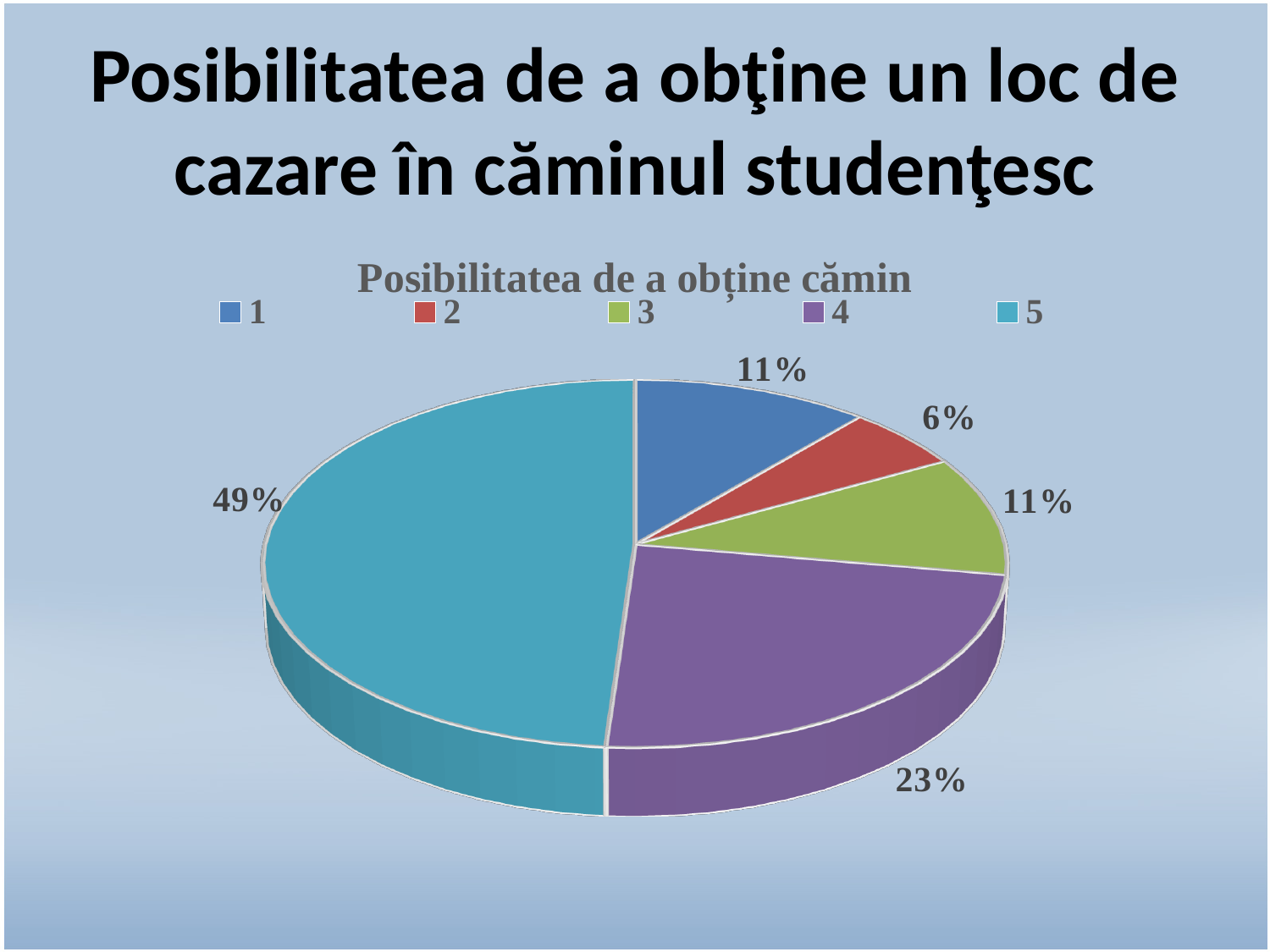
Which category has the largest slice? 5 What is the value for category 1? 11% Which is larger, the share for category 4 or the share for category 3? 4 What colour is the slice for category 5? teal/light blue What share of the pie does category 4 have? 23% What type of chart is shown on the slide? pie chart What is the chart's title? Posibilitatea de a obţine cămin How many categories does the legend list? 5 What is the difference between the shares of category 5 and category 4? 26% Which category has the smallest slice? 2 What share of the pie does category 5 have? 49% What is the value for category 2? 6%